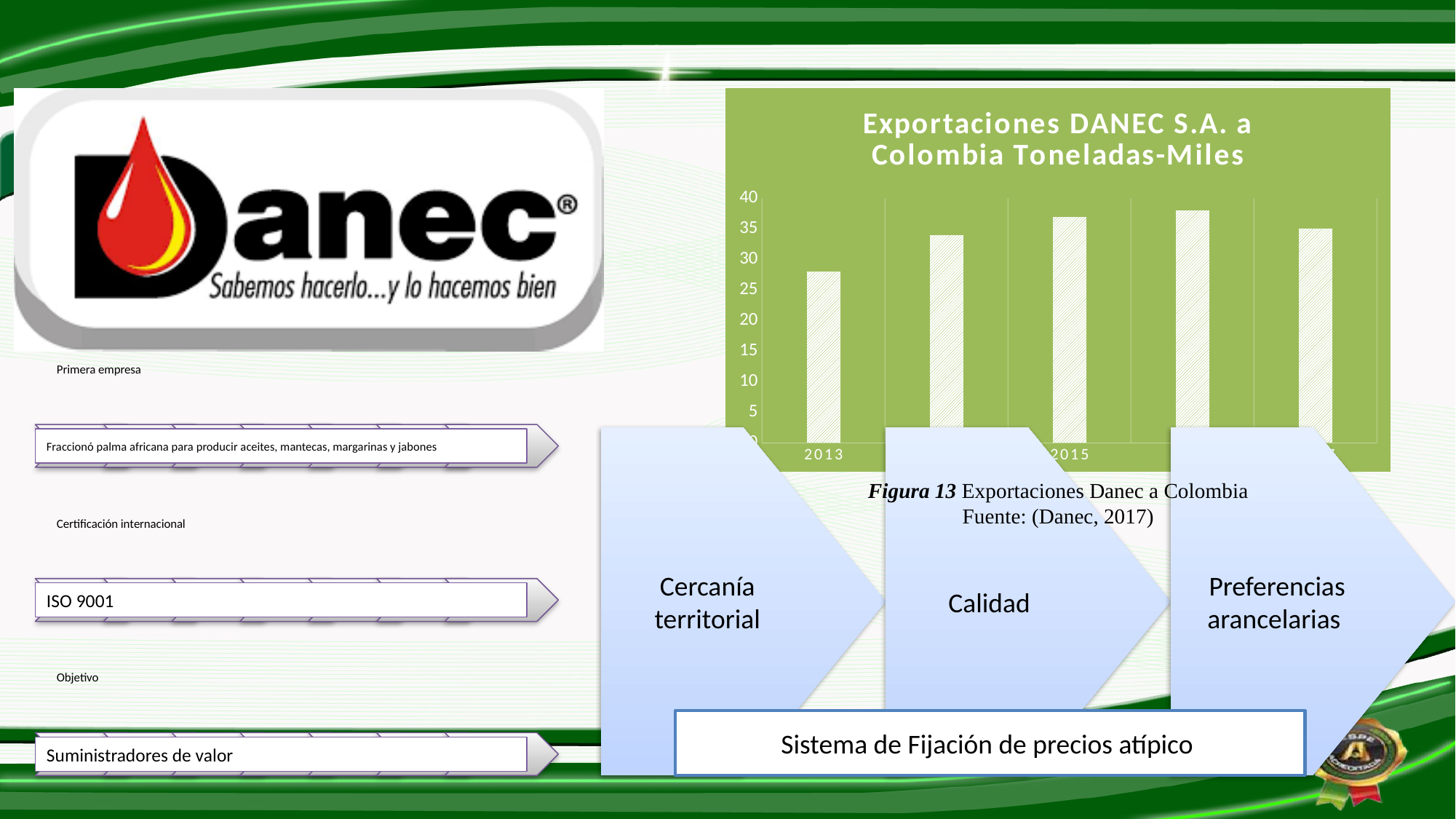
Which year has the lowest value in the chart? 2013 Which is larger, the value for 2013 or the value for 2015? 2015 What is the highest value shown on the vertical axis of the chart? 40 How many bars are plotted in the chart? 5 Is the value for 2013 greater or less than 30? less Do the values rise or fall from 2013 to 2015? rise What kind of chart is shown on the slide? bar chart Is the value for 2015 greater or less than 35? greater What is the title of the chart on the slide? Exportaciones DANEC S.A. a Colombia Toneladas-Miles Is the value for 2013 greater or less than 25? greater